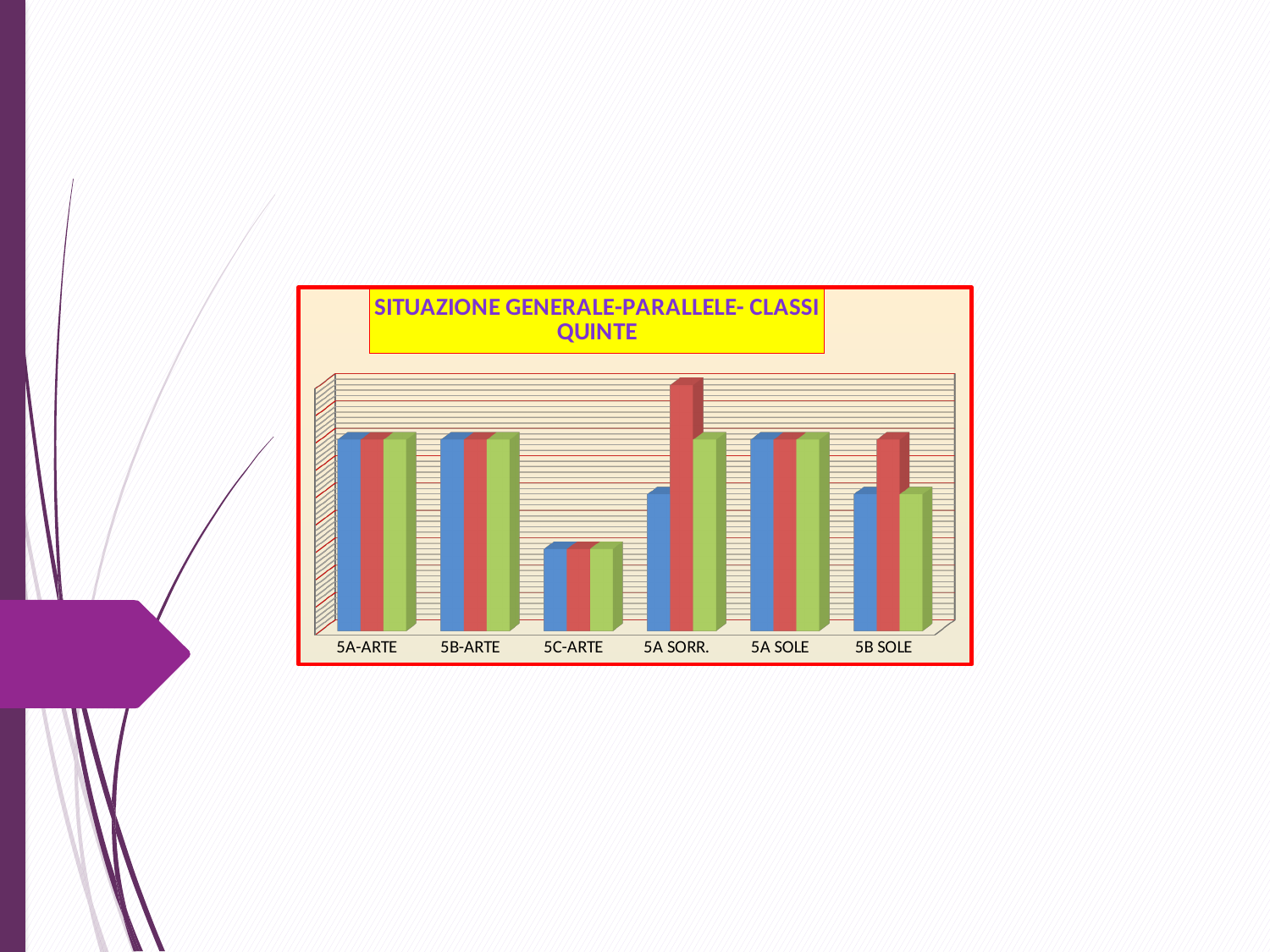
How many bars are plotted for each category in the chart? 3 What is the label of the fourth category from the left on the x axis? 5A SORR. Which category has the lowest bars in the chart? 5C-ARTE Which is larger: the red bar for 5A SORR. or the red bar for 5B SOLE? 5A SORR. Which is larger: the green bar for 5B-ARTE or the green bar for 5C-ARTE? 5B-ARTE How many categories are shown on the x axis of the chart? 6 Which is larger: the blue bar for 5A-ARTE or the blue bar for 5C-ARTE? 5A-ARTE Which category contains the single tallest bar in the chart? 5A SORR. What is the title of the chart? SITUAZIONE GENERALE-PARALLELE- CLASSI QUINTE What kind of chart is shown on the slide? Bar chart